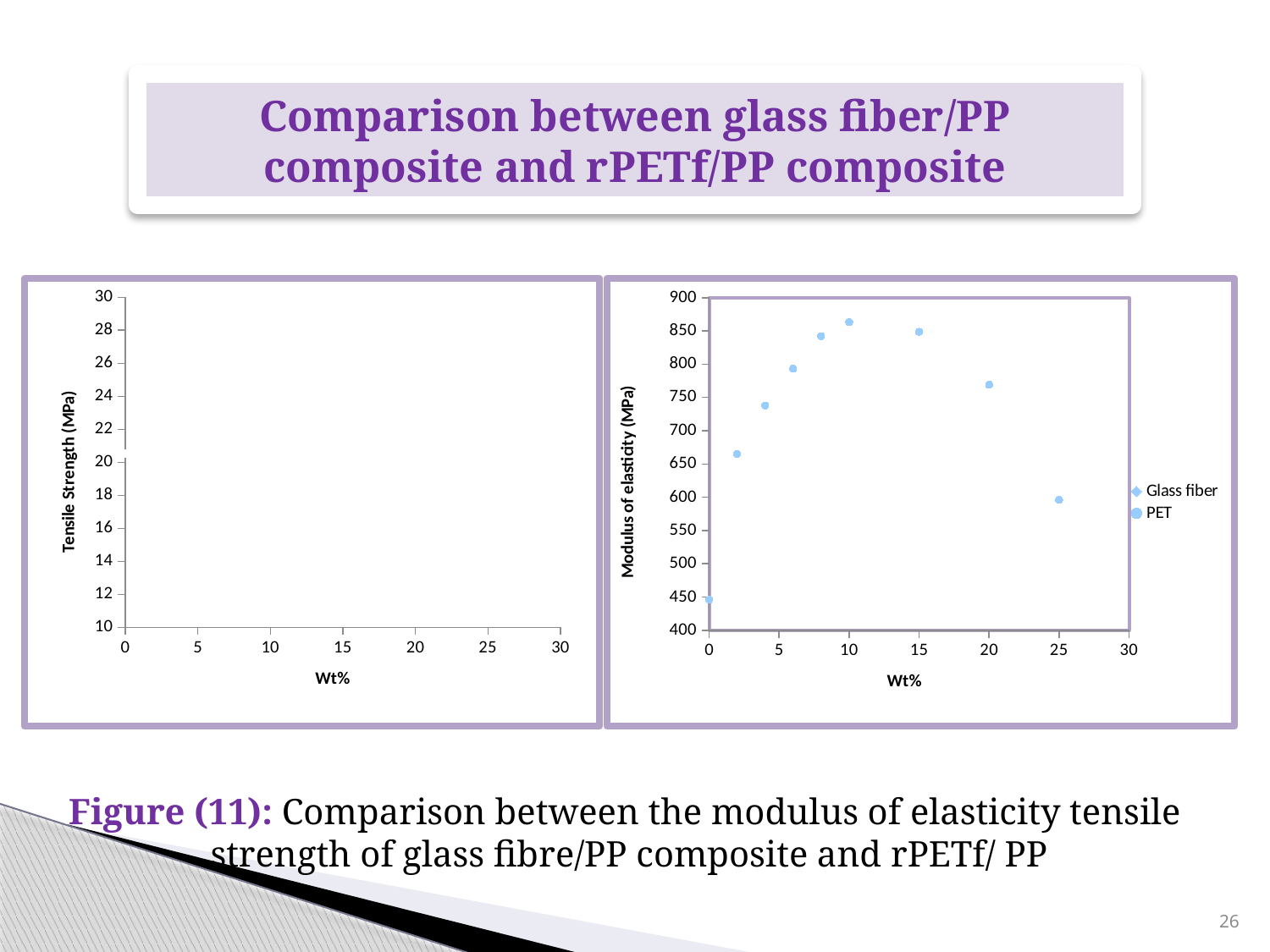
How many series does the legend of the right-hand chart list? 2 On the right-hand chart, at which Wt% is the modulus of elasticity lowest? 0 On the right-hand chart, is the modulus of elasticity at 25 Wt% greater or less than 650? less What kind of chart is the right-hand chart showing modulus of elasticity? scatter chart On the right-hand chart, is the modulus of elasticity at 20 Wt% greater or less than 750? greater How many data points are plotted on the right-hand chart (modulus of elasticity)? 9 What is the y-axis label of the left-hand chart? Tensile Strength (MPa) On the right-hand chart, does the modulus of elasticity rise or fall as Wt% increases from 10 to 25? fall On the right-hand chart, at which Wt% is the modulus of elasticity highest? 10 On the right-hand chart, is the modulus of elasticity at 0 Wt% greater or less than 500? less On the right-hand chart, which has the larger modulus of elasticity: 10 Wt% or 25 Wt%? 10 Wt%